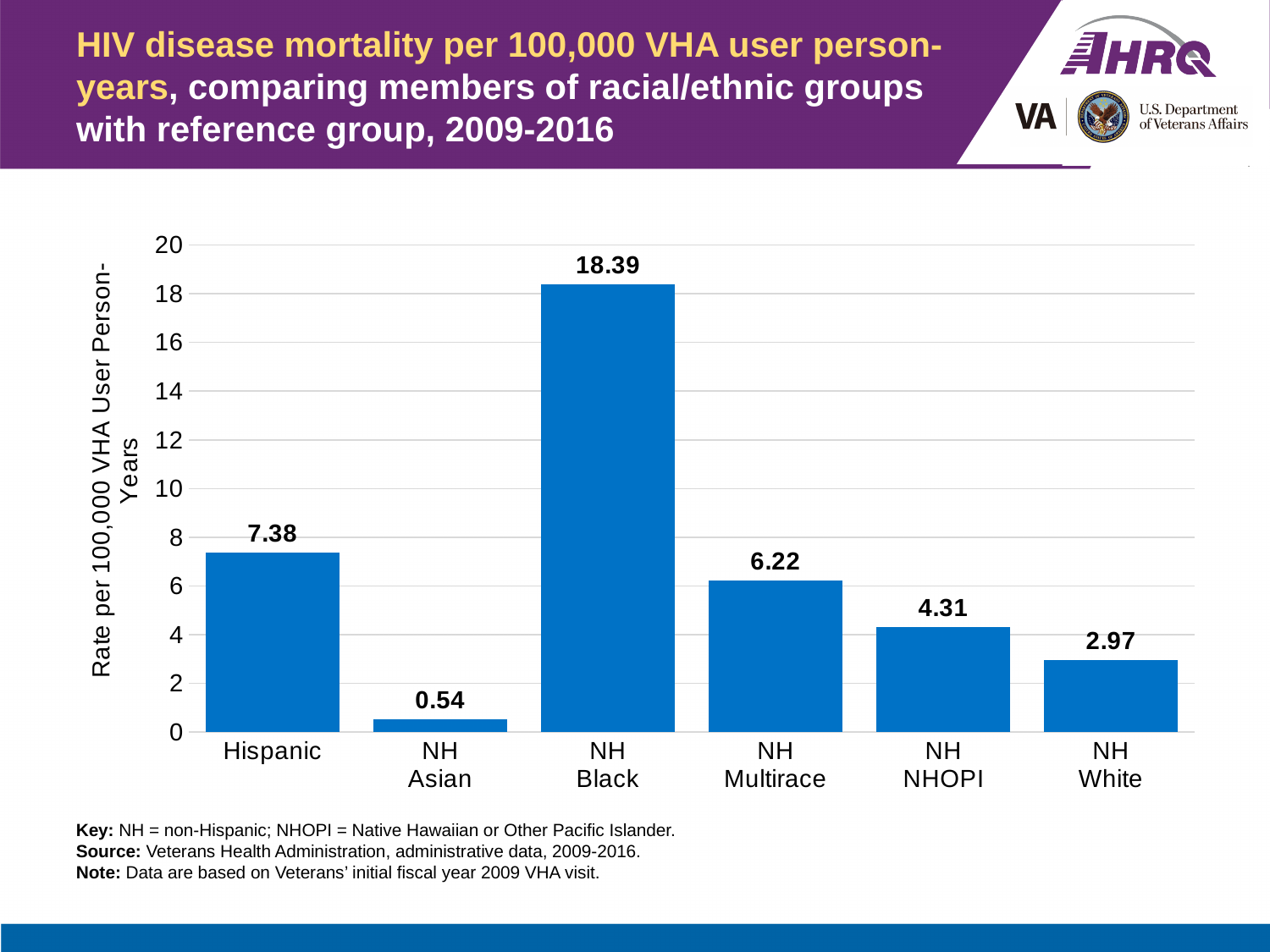
What is the label of the vertical axis? Rate per 100,000 VHA User Person-Years What is the HIV disease mortality rate for Hispanic VHA users? 7.38 Which racial/ethnic group has the lowest HIV disease mortality rate? NH Asian What type of chart is used on this slide? bar chart What is the value shown for NH NHOPI? 4.31 Which racial/ethnic group has the highest HIV disease mortality rate? NH Black What is the difference between the rates for Hispanic and NH Multirace? 1.16 Is the value for NH White greater or less than 4? less Which has a higher HIV disease mortality rate, NH Multirace or NH NHOPI? NH Multirace What is the difference between the HIV disease mortality rates for NH Black and NH White? 15.42 How many racial/ethnic groups are shown on the chart? 6 What is the HIV disease mortality rate per 100,000 VHA user person-years for NH Black? 18.39